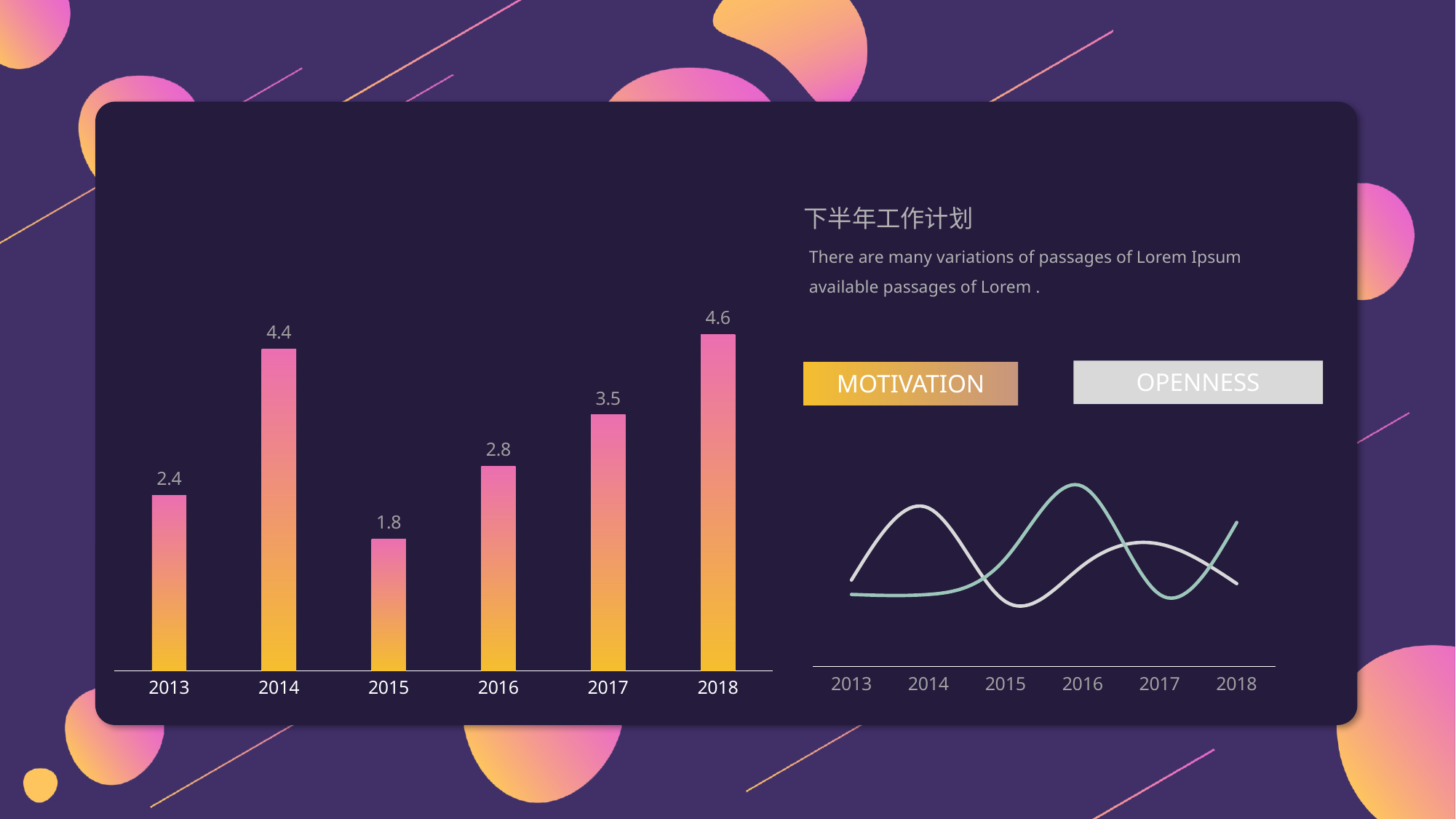
In the bar chart on the left, which is larger, the value for 2016 or the value for 2017? 2017 In the bar chart on the left, how many years are shown on the x axis? 6 In the line chart on the right, how many lines are plotted? 2 What kind of chart is the chart on the right of the slide, below the MOTIVATION and OPENNESS labels? line chart In the bar chart on the left, do the values rise or fall from 2015 to 2018? rise In the bar chart on the left, which year has the highest value? 2018 In the bar chart on the left, what is the difference between the values for 2018 and 2013? 2.2 In the bar chart on the left, what is the value for 2014? 4.4 In the bar chart on the left, what is the value for 2017? 3.5 What kind of chart is the chart on the left of the slide? bar chart In the bar chart on the left, what is the difference between the values for 2014 and 2015? 2.6 In the bar chart on the left, which year has the lowest value? 2015